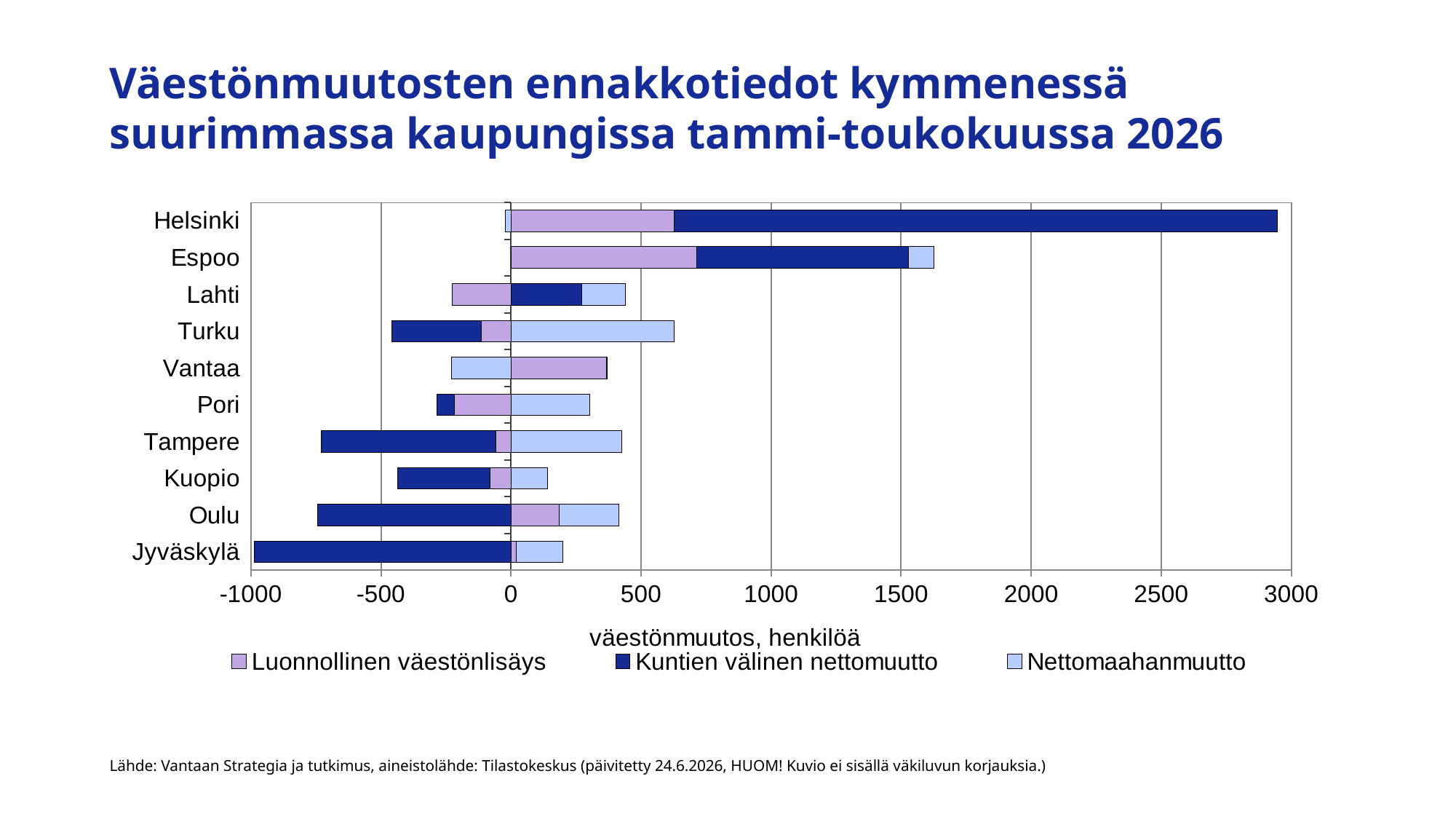
How many cities are shown on the chart? 10 What kind of chart is shown on the slide? bar chart How many series does the legend list? 3 Which city has the largest Nettomaahanmuutto? Turku Is the Luonnollinen väestönlisäys for Espoo greater or less than 500? greater Which city has the most negative Kuntien välinen nettomuutto? Jyväskylä Which city has the larger Nettomaahanmuutto, Tampere or Kuopio? Tampere What is the title of the x axis? väestönmuutos, henkilöä Is the Kuntien välinen nettomuutto for Oulu greater or less than -500? less Is the Kuntien välinen nettomuutto for Helsinki greater or less than 2000? greater Which city has the largest Kuntien välinen nettomuutto? Helsinki